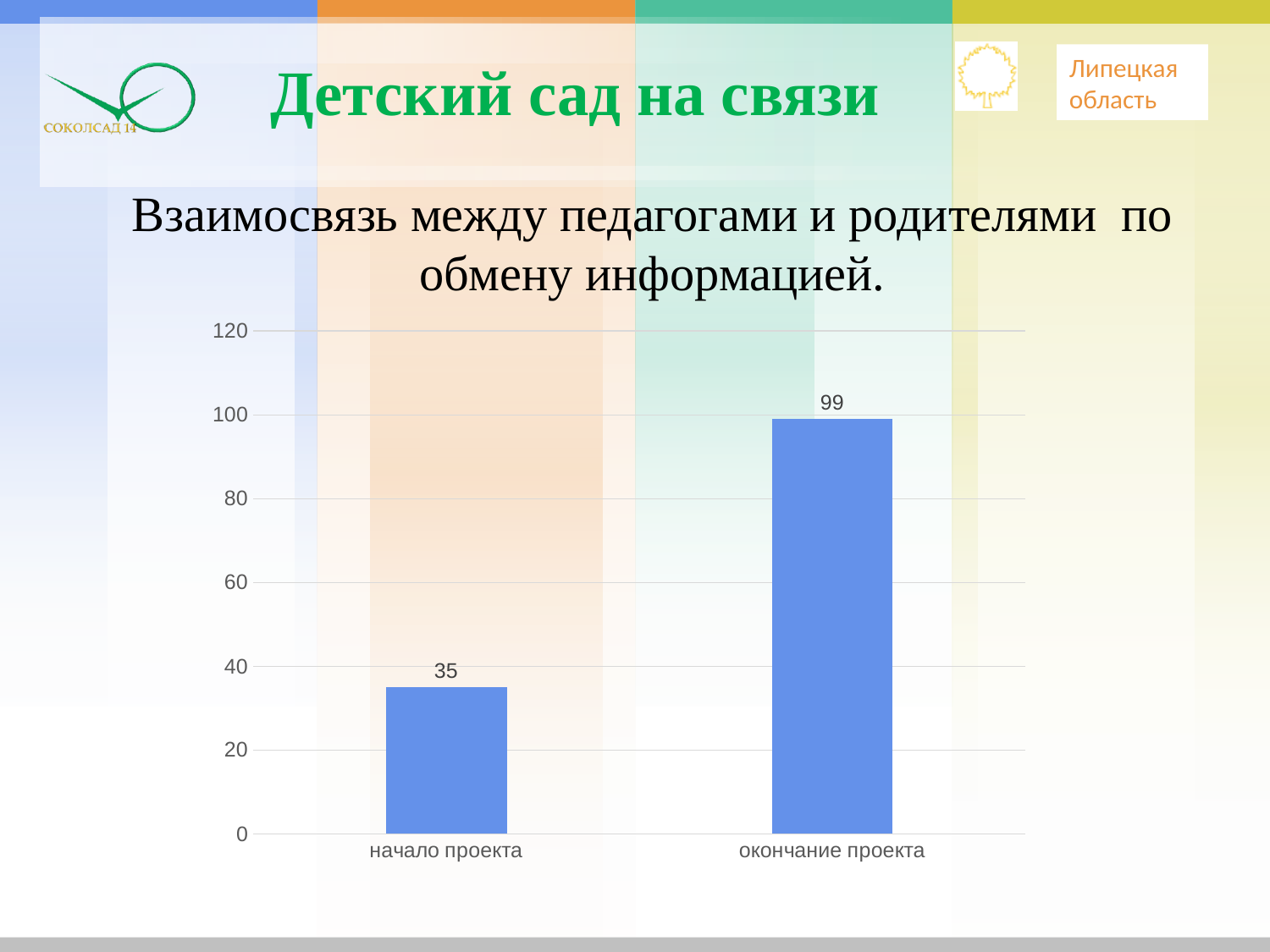
What is the difference between the values for "окончание проекта" and "начало проекта"? 64 Is the value for "окончание проекта" greater or less than 80? greater Which is larger, the value for "начало проекта" or for "окончание проекта"? окончание проекта How many categories are shown on the x axis? 2 What is the value for "окончание проекта"? 99 What kind of chart is shown on the slide? bar chart Do the values rise or fall from "начало проекта" to "окончание проекта"? rise Which category has the highest value? окончание проекта Which category has the lowest value? начало проекта Is the value for "начало проекта" greater or less than 40? less What is the value for "начало проекта"? 35 What is the highest value shown on the y axis? 120